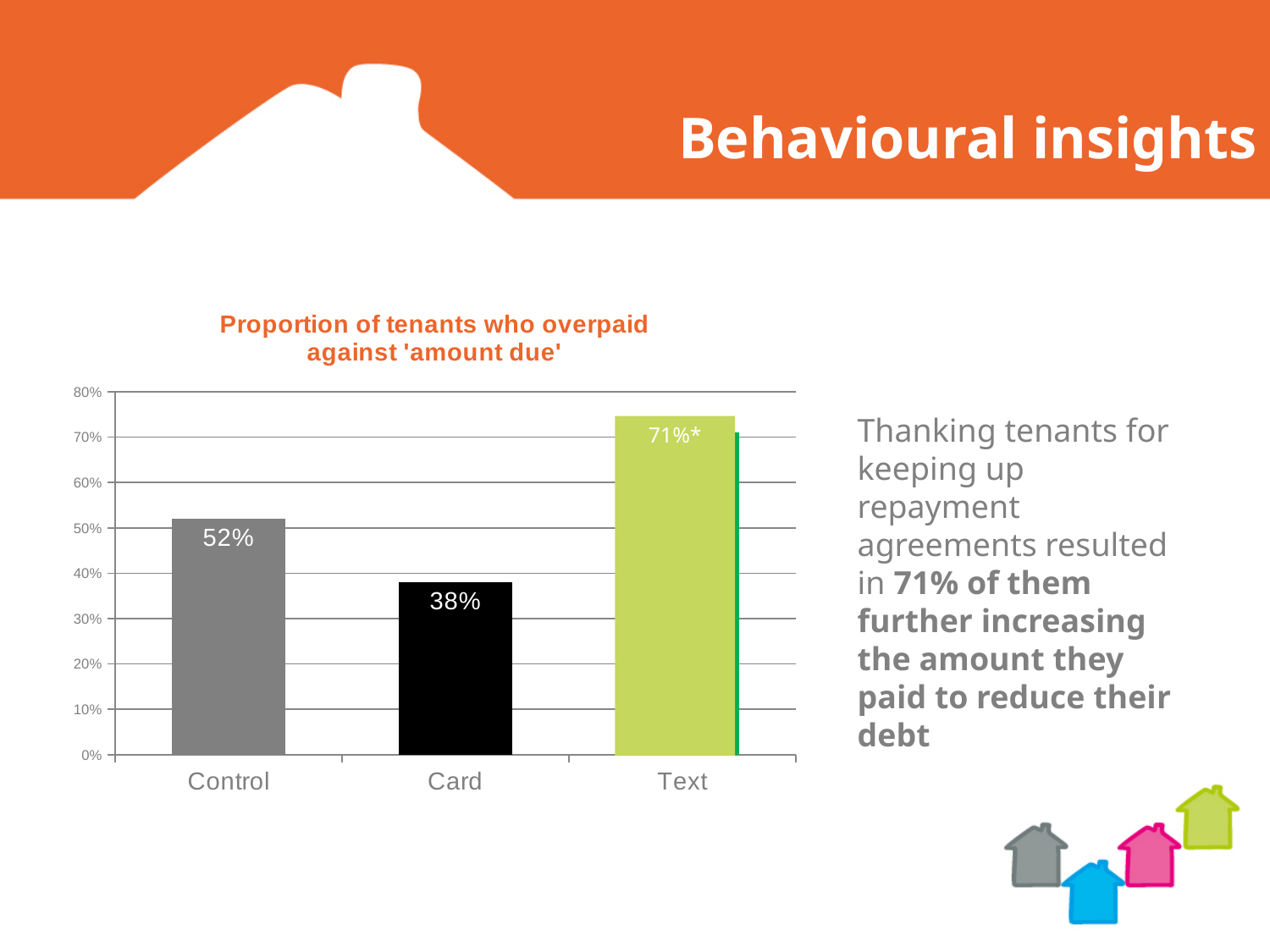
Is the value for Text greater or less than 60%? greater Which is larger, the value for Control or the value for Card? Control What is the difference between the values for Text and Control? 19 percentage points What is the difference between the values for Control and Card? 14 percentage points Which category has the highest value? Text Which category has the lowest value? Card What is the value shown on the Text bar? 71%* What is the value for Control? 52% What is the title of the chart? Proportion of tenants who overpaid against 'amount due' What kind of chart is shown on the slide? Bar chart How many categories are shown on the x axis? 3 What is the value for Card? 38%